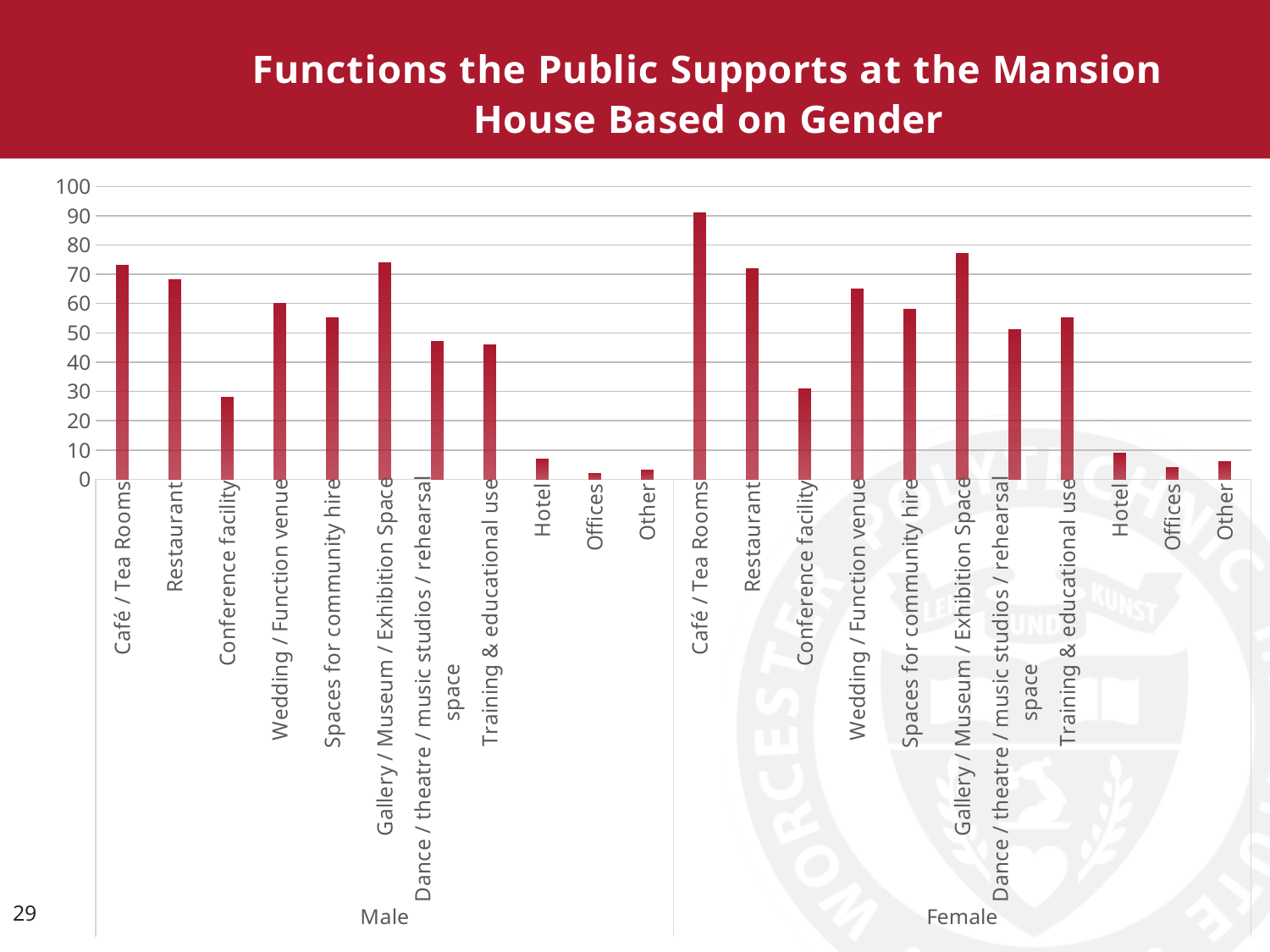
Is the value for Gallery / Museum / Exhibition Space in the Female group greater or less than 70? greater What kind of chart is shown on the slide? Bar chart Is the value for Conference facility in the Male group greater or less than 40? less In the Male group, which is larger: Restaurant or Conference facility? Restaurant Which two gender groups are shown along the x axis? Male and Female Which function has the highest value in the Female group? Café / Tea Rooms Is the value for Café / Tea Rooms in the Male group greater or less than 60? greater Which is larger: Café / Tea Rooms for Male or Café / Tea Rooms for Female? Female What is the title of the chart? Functions the Public Supports at the Mansion House Based on Gender How many function categories are plotted for each gender group? 11